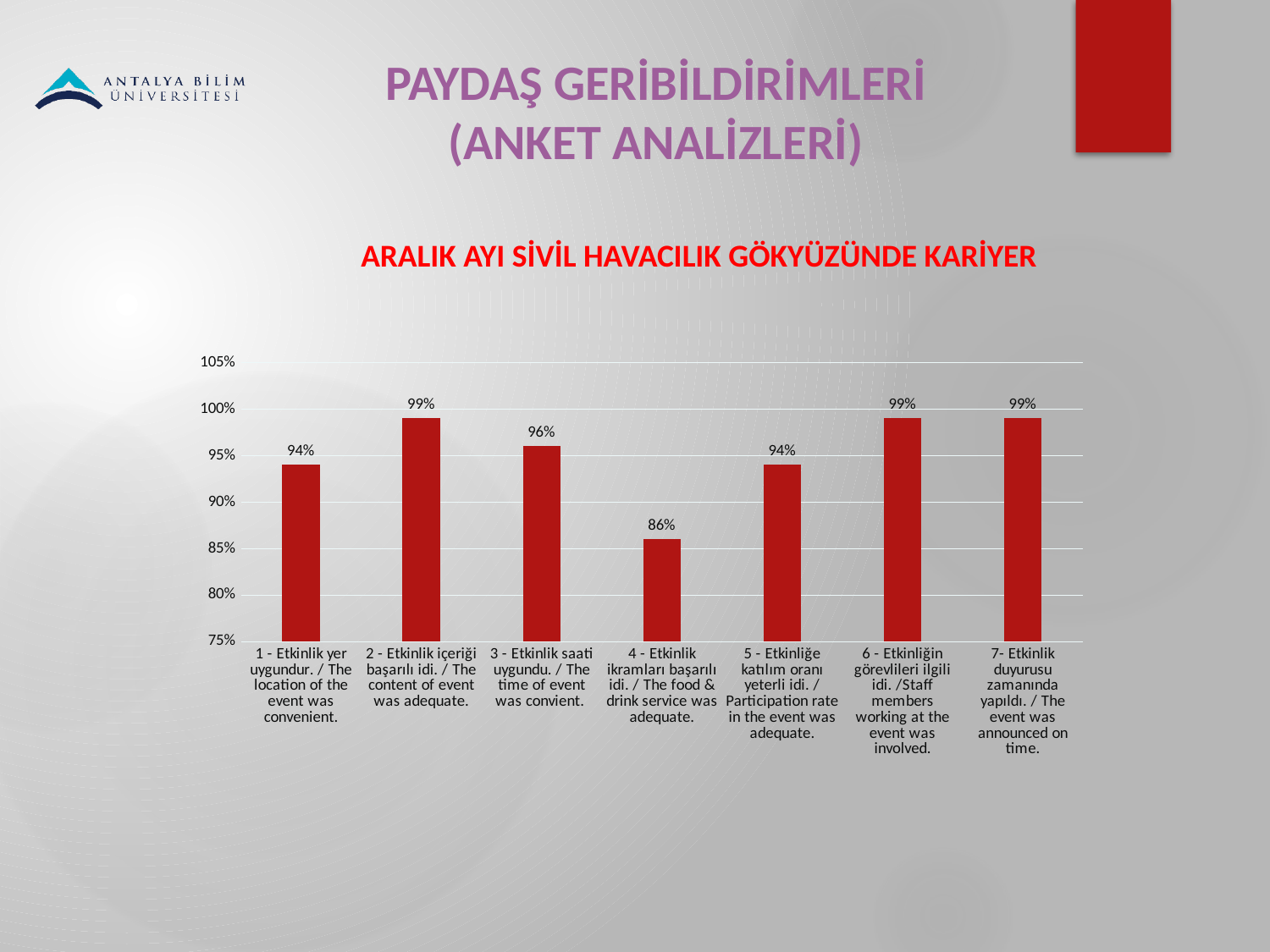
What is the value for statement 6 (Etkinliğin görevlileri ilgili idi / Staff members working at the event was involved)? 99% Which statement has the lowest value in the chart? 4 - Etkinlik ikramları başarılı idi. / The food & drink service was adequate. How many statements have a value of 99%? 3 How many categories (survey statements) are plotted in the chart? 7 What is the value for statement 4 (Etkinlik ikramları başarılı idi / The food & drink service was adequate)? 86% What kind of chart is shown on the slide? bar chart Which is larger: the value for statement 3 (time of event) or statement 5 (participation rate)? statement 3 (time of event), 96% Is the value for statement 4 (food & drink service) greater or less than 90%? less What is the heading shown above the chart? ARALIK AYI SİVİL HAVACILIK GÖKYÜZÜNDE KARİYER What is the difference between the value for statement 2 (content of event was adequate) and statement 4 (food & drink service was adequate)? 13 percentage points What is the value for statement 1 (Etkinlik yer uygundur / The location of the event was convenient)? 94% What is the value for statement 3 (Etkinlik saati uygundu / The time of event was convient)? 96%